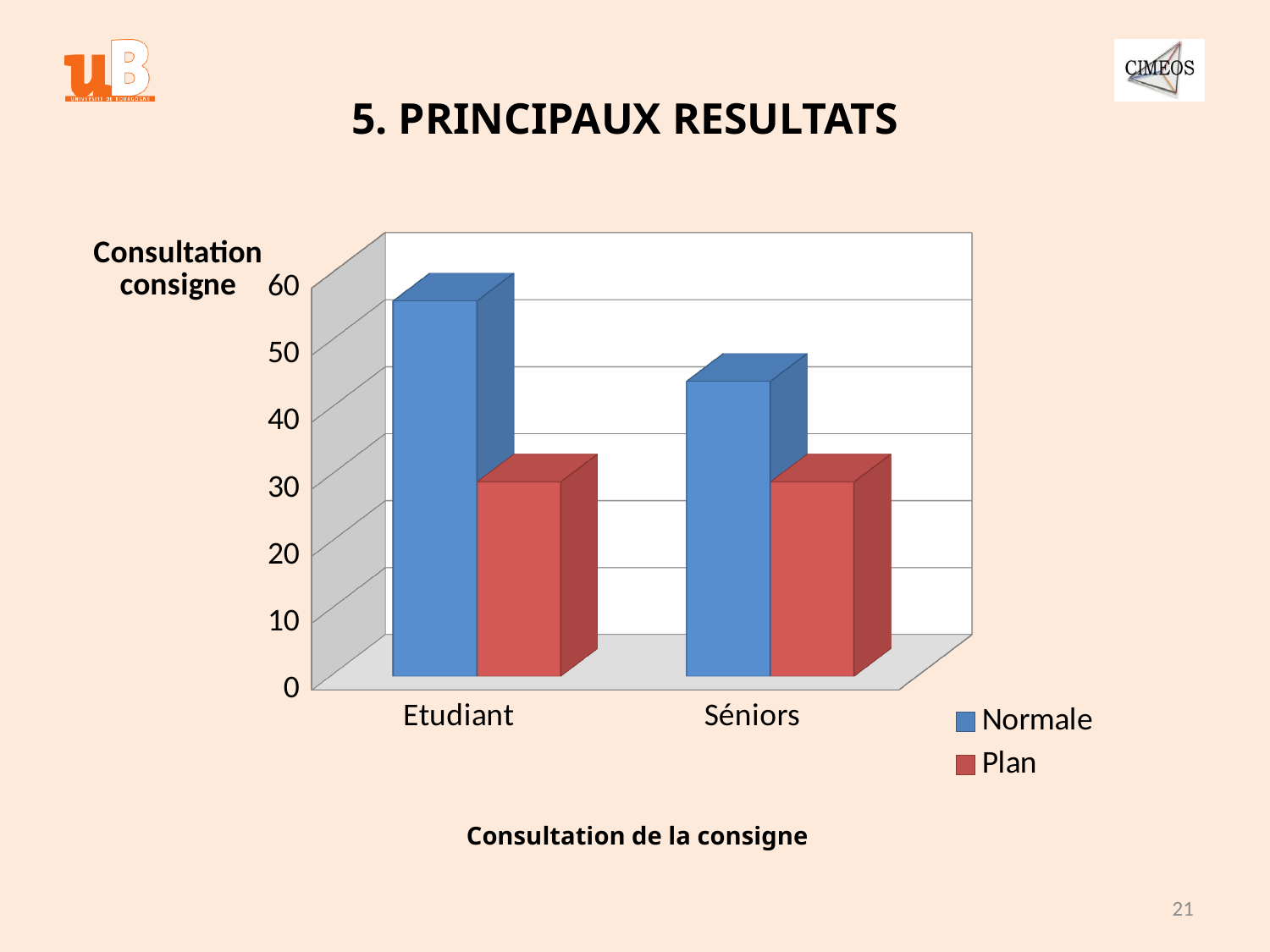
Is the Normale value for Séniors greater or less than 50? less Which category has the lowest value for the Normale series? Séniors What is the title shown below the chart? Consultation de la consigne Is the Normale value for Etudiant greater or less than 50? greater How many categories are shown on the x axis of the chart? 2 Which category has the highest value for the Normale series? Etudiant How many series does the chart legend list? 2 For Séniors, which is larger: Normale or Plan? Normale Is the Plan value for Etudiant greater or less than 40? less What kind of chart is shown on the slide? bar chart For Etudiant, which is larger: Normale or Plan? Normale Which series are listed in the chart legend? Normale, Plan